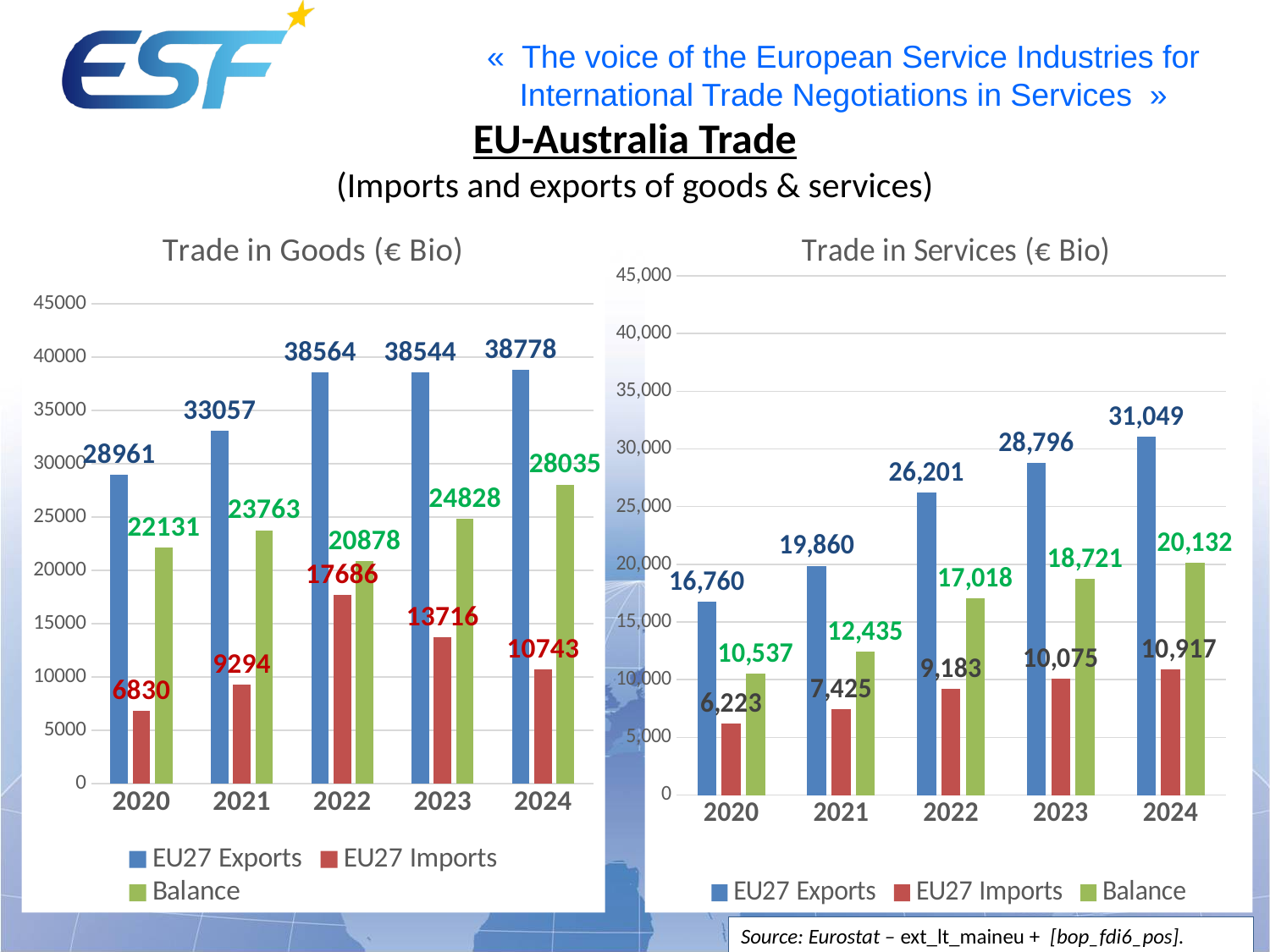
In the Trade in Services (€ Bio) chart, which year has the lowest EU27 Exports value? 2020 In the Trade in Goods (€ Bio) chart, what is the difference between the Balance in 2024 and the Balance in 2020? 5904 In the Trade in Services (€ Bio) chart, what is the difference between EU27 Exports and EU27 Imports in 2023? 18,721 In the Trade in Goods (€ Bio) chart, which is larger: EU27 Imports in 2023 or EU27 Imports in 2024? EU27 Imports in 2023 In the Trade in Services (€ Bio) chart, what is the value of EU27 Imports in 2022? 9,183 In the Trade in Goods (€ Bio) chart, what is the value of EU27 Imports in 2020? 6830 How many series does the legend of the Trade in Goods (€ Bio) chart list? 3 In the Trade in Goods (€ Bio) chart, what is the value of EU27 Exports in 2022? 38564 How many years are shown on the x axis of the Trade in Services (€ Bio) chart? 5 In the Trade in Services (€ Bio) chart, what is the Balance value for 2024? 20,132 In the Trade in Goods (€ Bio) chart, which year has the highest EU27 Imports value? 2022 In the Trade in Services (€ Bio) chart, do EU27 Exports rise or fall from 2020 to 2024? rise